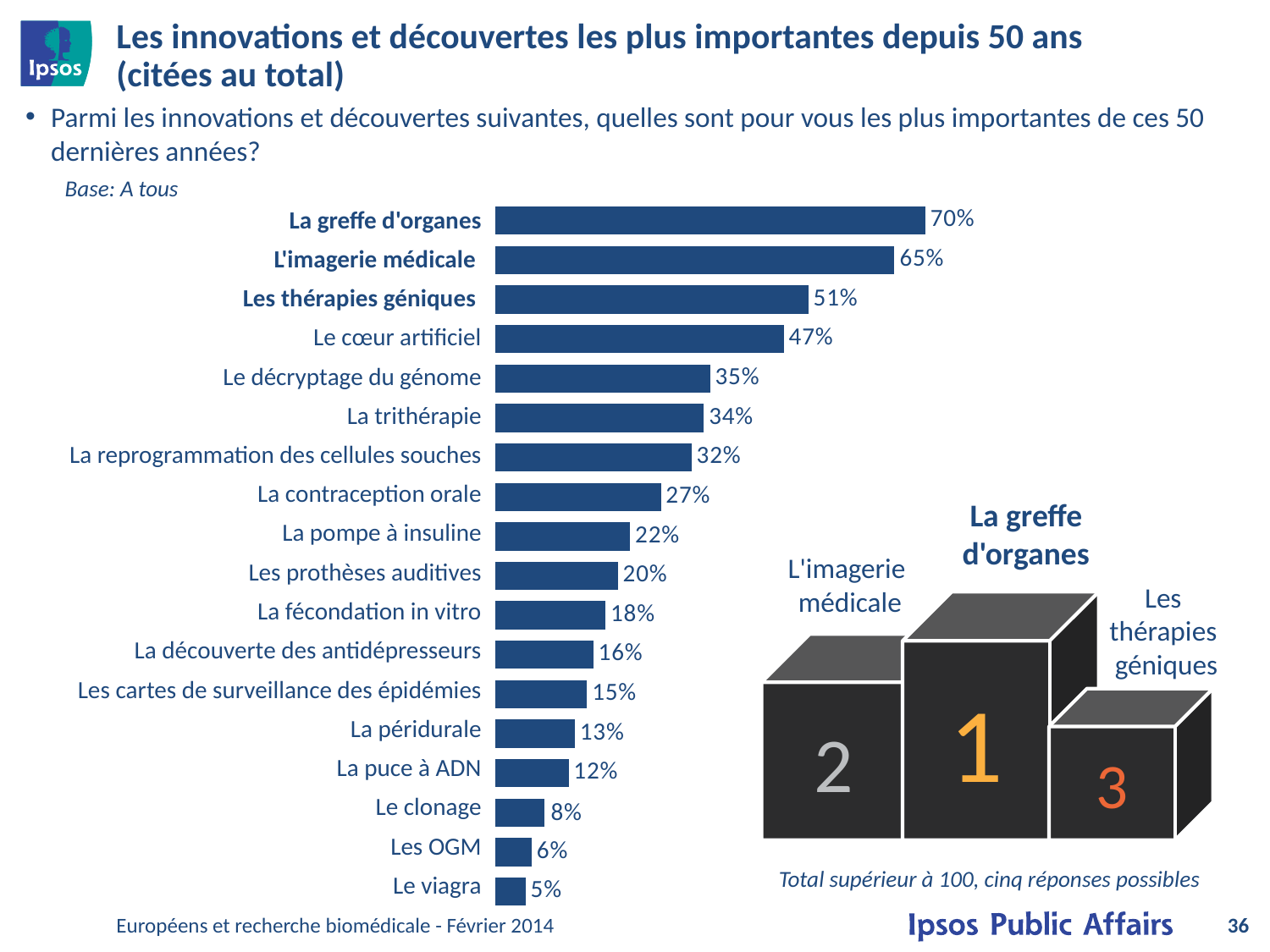
What percentage of respondents cited La greffe d'organes? 70% What is the difference in percentage points between L'imagerie médicale and Les thérapies géniques? 14 How many innovations or discoveries are listed in the bar chart? 18 Which innovation is shown in position 2 on the podium graphic? L'imagerie médicale What type of chart is used to display the percentages? Bar chart What is the value shown for Le décryptage du génome? 35% What is the difference in percentage points between Le clonage and Les OGM? 2 Which has a higher value, La contraception orale or La pompe à insuline? La contraception orale What percentage is shown for La péridurale? 13% Which has a higher value, Le cœur artificiel or La trithérapie? Le cœur artificiel Which innovation has the lowest percentage in the chart? Le viagra Which innovation has the highest percentage in the chart? La greffe d'organes